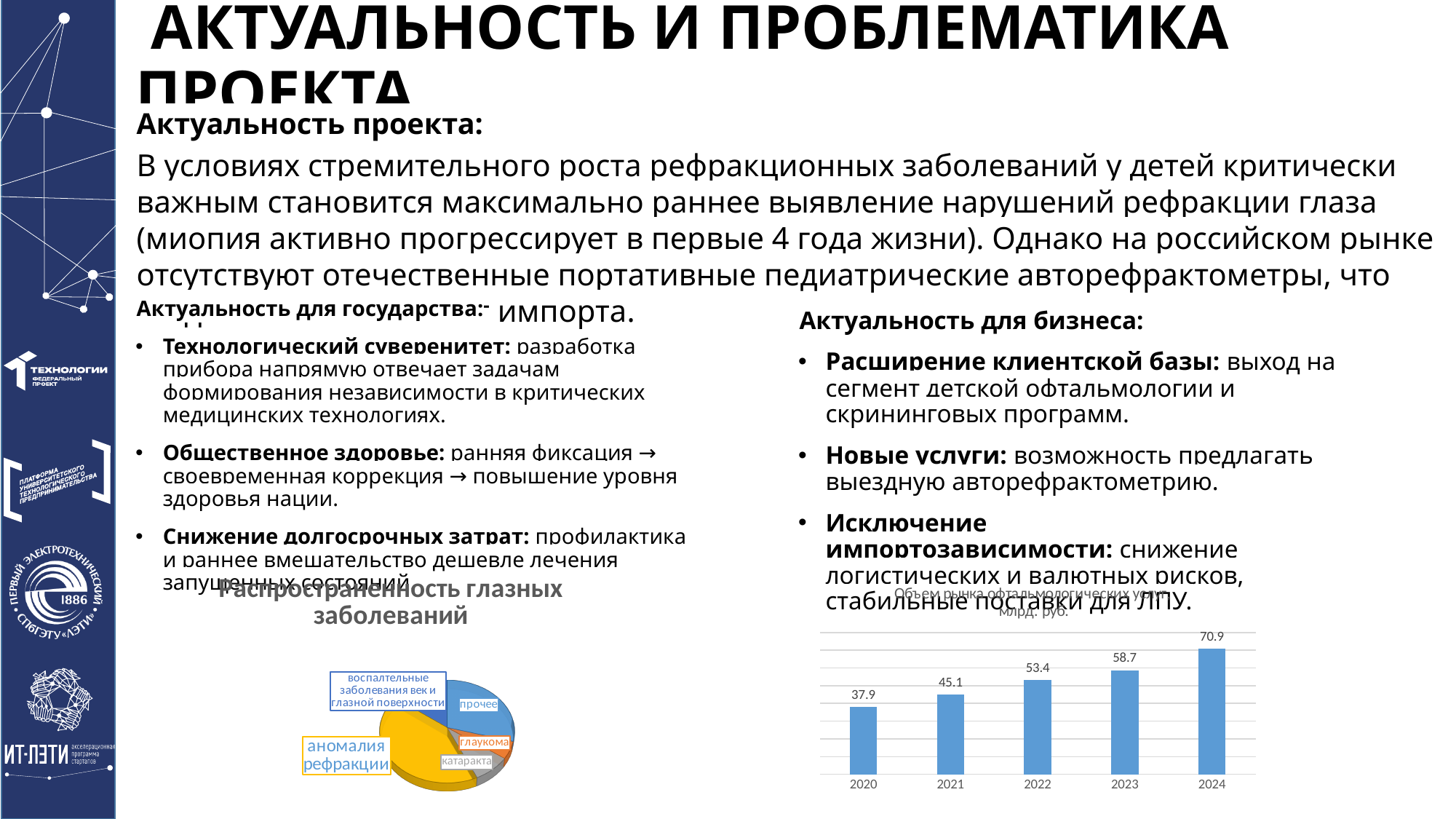
On the bar chart on the right of the slide, which year has the lowest value? 2020 On the bar chart on the right of the slide, what is the difference between the values for 2021 and 2020? 7.2 How many slices does the pie chart titled "Распространенность глазных заболеваний" have? 5 On the bar chart on the right of the slide, what is the value for 2020? 37.9 How many years are shown on the bar chart on the right of the slide? 5 On the bar chart on the right of the slide, what is the difference between the values for 2024 and 2023? 12.2 What kind of chart is the chart titled "Распространенность глазных заболеваний"? pie chart On the bar chart on the right of the slide, which year has the highest value? 2024 On the bar chart on the right of the slide, what is the value for 2024? 70.9 On the bar chart on the right of the slide, do the values rise or fall from 2020 to 2024? rise On the pie chart titled "Распространенность глазных заболеваний", which slice is the largest? аномалия рефракции On the bar chart on the right of the slide, what is the value for 2022? 53.4